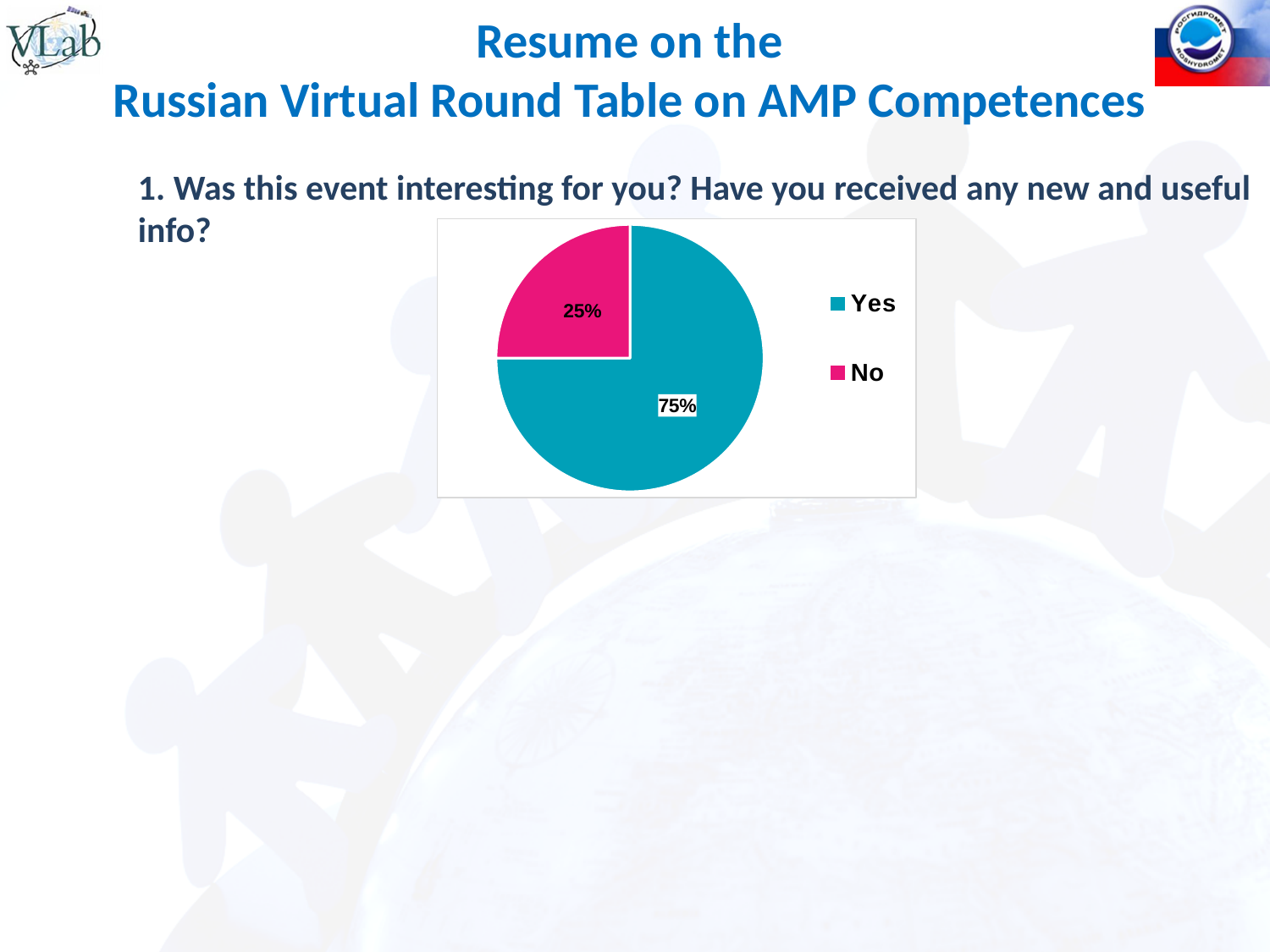
What share of the pie does the "Yes" slice represent? 75% How many slices does the pie chart have? 2 What kind of chart is shown on the slide? pie chart What is the difference in percentage points between the "Yes" and "No" slices? 50% What share of the pie does the "No" slice represent? 25% How many entries does the legend list? 2 Which slice is the largest in the pie chart? Yes Which legend entry is shown in teal? Yes Which is larger, the "Yes" slice or the "No" slice? Yes Which slice is the smallest in the pie chart? No What colour is the "No" slice in the pie chart? pink